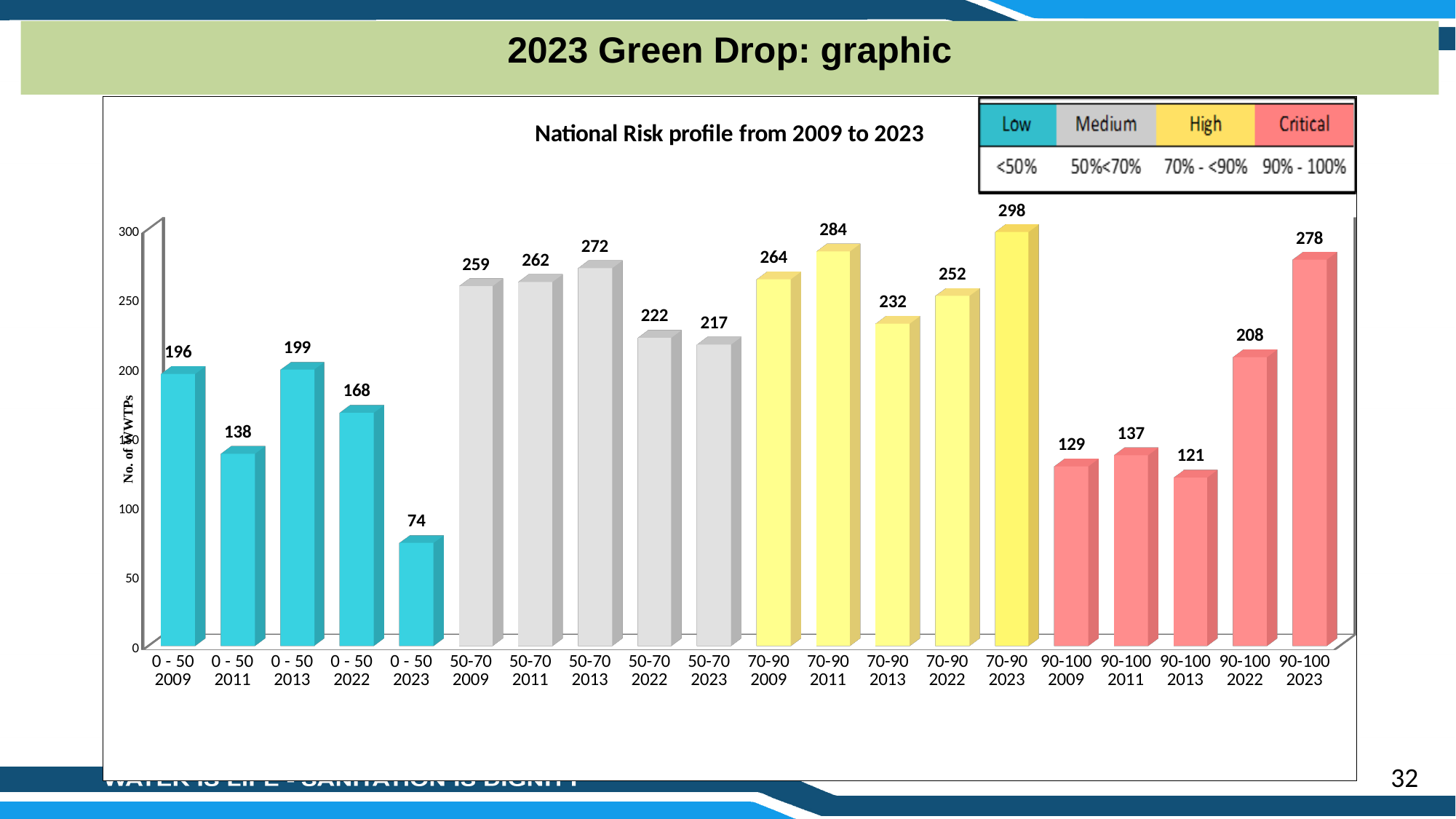
What is the value for 0 - 50 2009? 196 What is the title of the chart? National Risk profile from 2009 to 2023 What kind of chart is shown? bar chart Do the values for the 0 - 50 group rise or fall from 2022 to 2023? fall Which is larger, the value for 70-90 2011 or the value for 50-70 2013? 70-90 2011 Which category has the lowest value? 0 - 50 2023 Which category has the highest value? 70-90 2023 What is the value for 50-70 2013? 272 What is the value for 90-100 2023? 278 How many bars are plotted in the chart? 20 Is the value for 90-100 2013 greater or less than 150? less What is the difference between the values for 90-100 2023 and 90-100 2022? 70